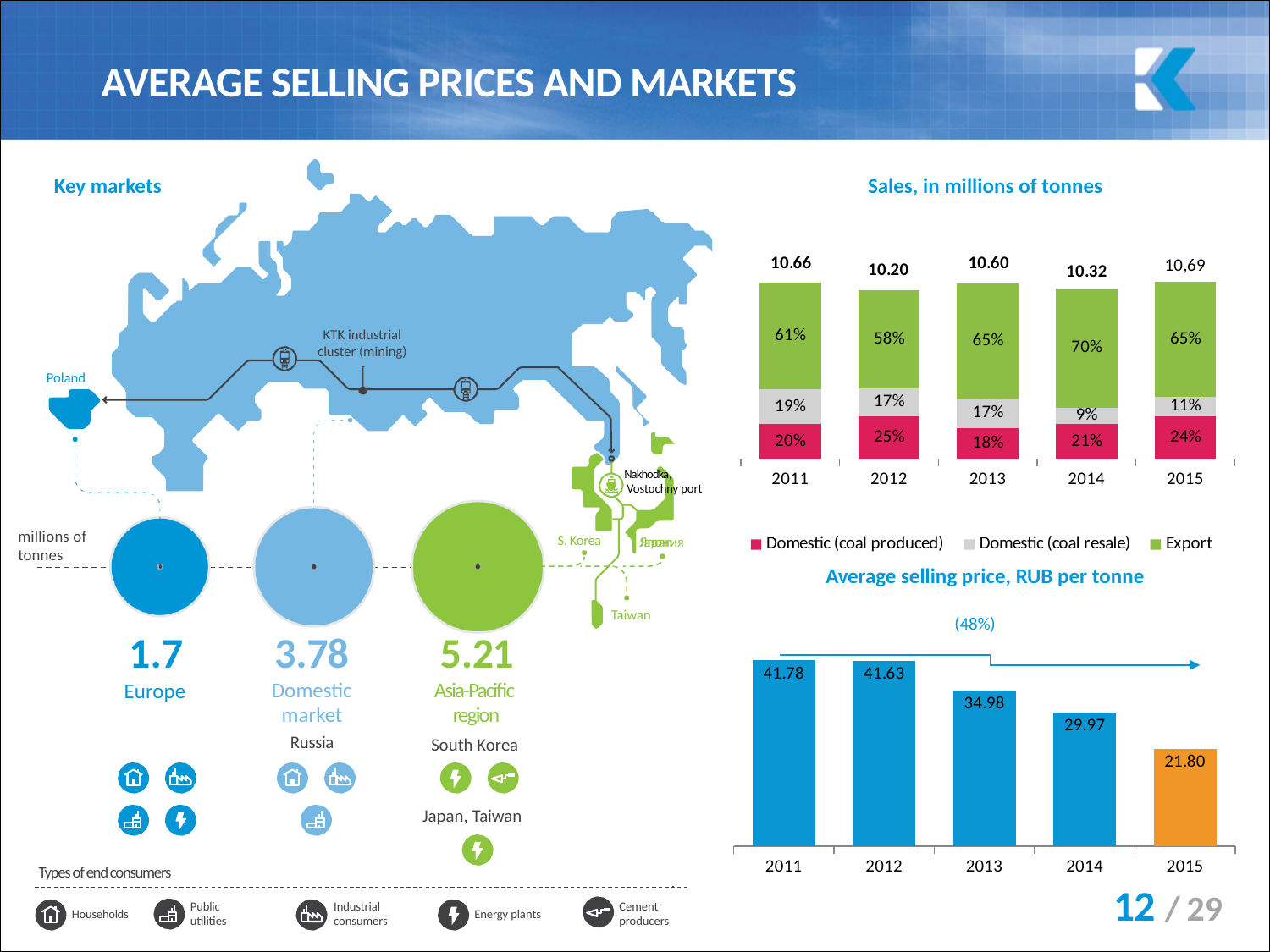
In the 'Sales, in millions of tonnes' chart, what share of 2012 sales was Domestic (coal produced)? 25% In the 'Sales, in millions of tonnes' chart, what share of 2014 sales was Export? 70% In the 'Average selling price, RUB per tonne' chart, which year has the lowest value? 2015 In the 'Sales, in millions of tonnes' chart, which year has the highest Export share? 2014 In the 'Sales, in millions of tonnes' chart, which colour represents Export? Green In the 'Sales, in millions of tonnes' chart, what is the total for 2011? 10.66 How many series does the legend of the 'Sales, in millions of tonnes' chart list? 3 What kind of chart is the 'Average selling price, RUB per tonne' chart? Bar chart In the 'Average selling price, RUB per tonne' chart, what is the value for 2013? 34.98 In the 'Average selling price, RUB per tonne' chart, what is the difference between the 2011 and 2015 values? 19.98 In the 'Average selling price, RUB per tonne' chart, do the values rise or fall from 2011 to 2015? Fall In the 'Sales, in millions of tonnes' chart, which year has the lowest Domestic (coal resale) share? 2014